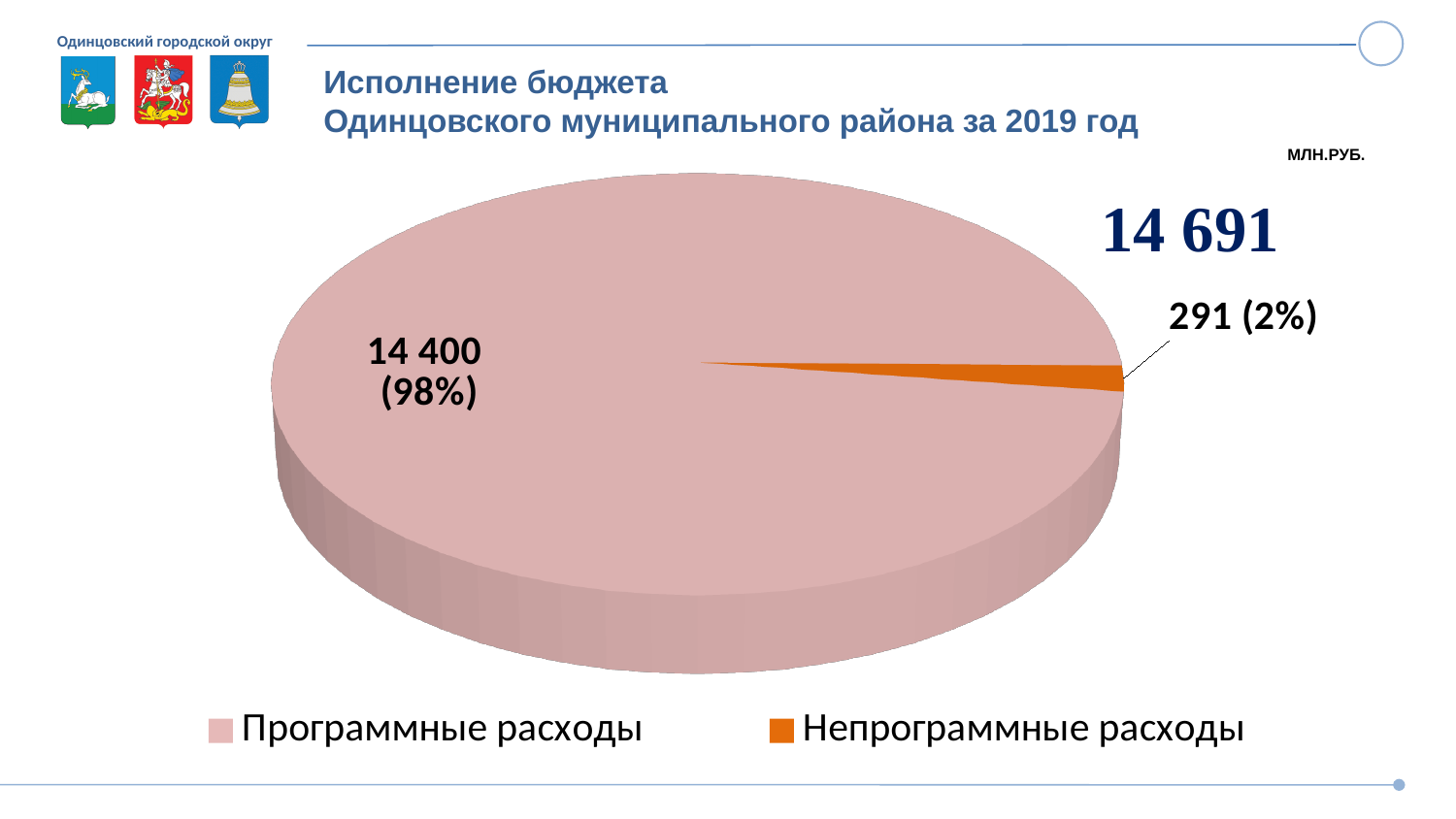
What is the value for Программные расходы? 14 400 What is the value for Непрограммные расходы? 291 What colour is the slice for Непрограммные расходы? orange What share of the pie does Программные расходы take? 98% Which category has the largest slice? Программные расходы Which category has the smallest slice? Непрограммные расходы What total value is printed above the chart? 14 691 How many categories does the pie chart have? 2 Which is larger, Программные расходы or Непрограммные расходы? Программные расходы What kind of chart is shown on the slide? pie chart What share of the pie does Непрограммные расходы take? 2% What is the difference between Программные расходы and Непрограммные расходы? 14 109